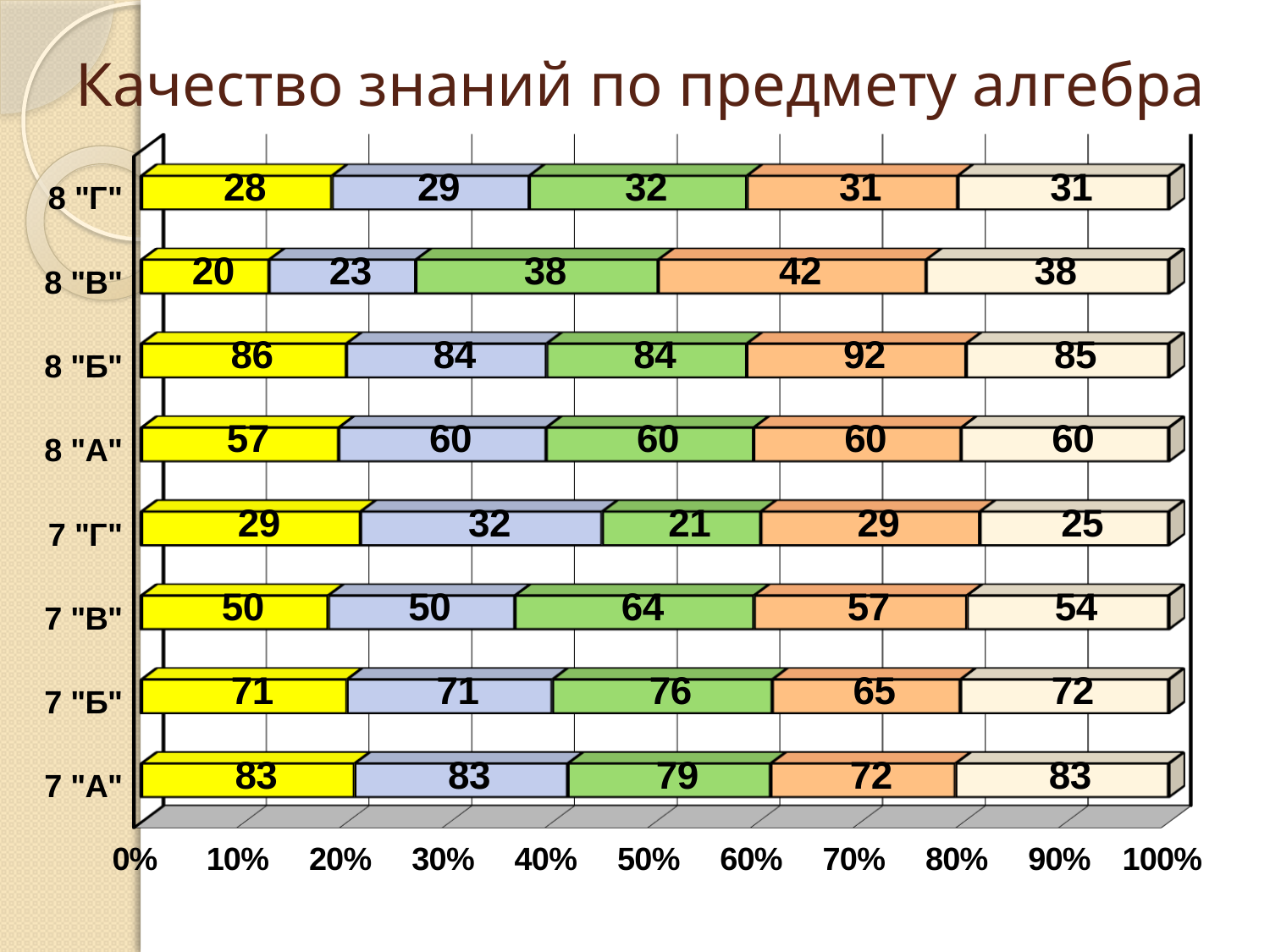
Which is larger: the green segment value for class 7 "В" or for class 7 "Б"? 7 "Б" What is the difference between the orange segment values of class 8 "Б" and class 8 "В"? 50 What is the sum of the five values labelled on the bar for class 8 "Г"? 151 What is the value of the beige (last) segment for class 7 "А"? 83 What is the value of the orange segment for class 8 "В"? 42 What is the value of the green segment for class 7 "Г"? 21 How many classes (categories) are shown on the chart? 8 What is the value of the yellow segment for class 8 "Б"? 86 What type of chart is shown on the slide? stacked bar chart Which class has the highest value in the yellow (first) segment? 8 "Б" What is the title of the chart? Качество знаний по предмету алгебра Which class has the lowest value in the yellow (first) segment? 8 "В"